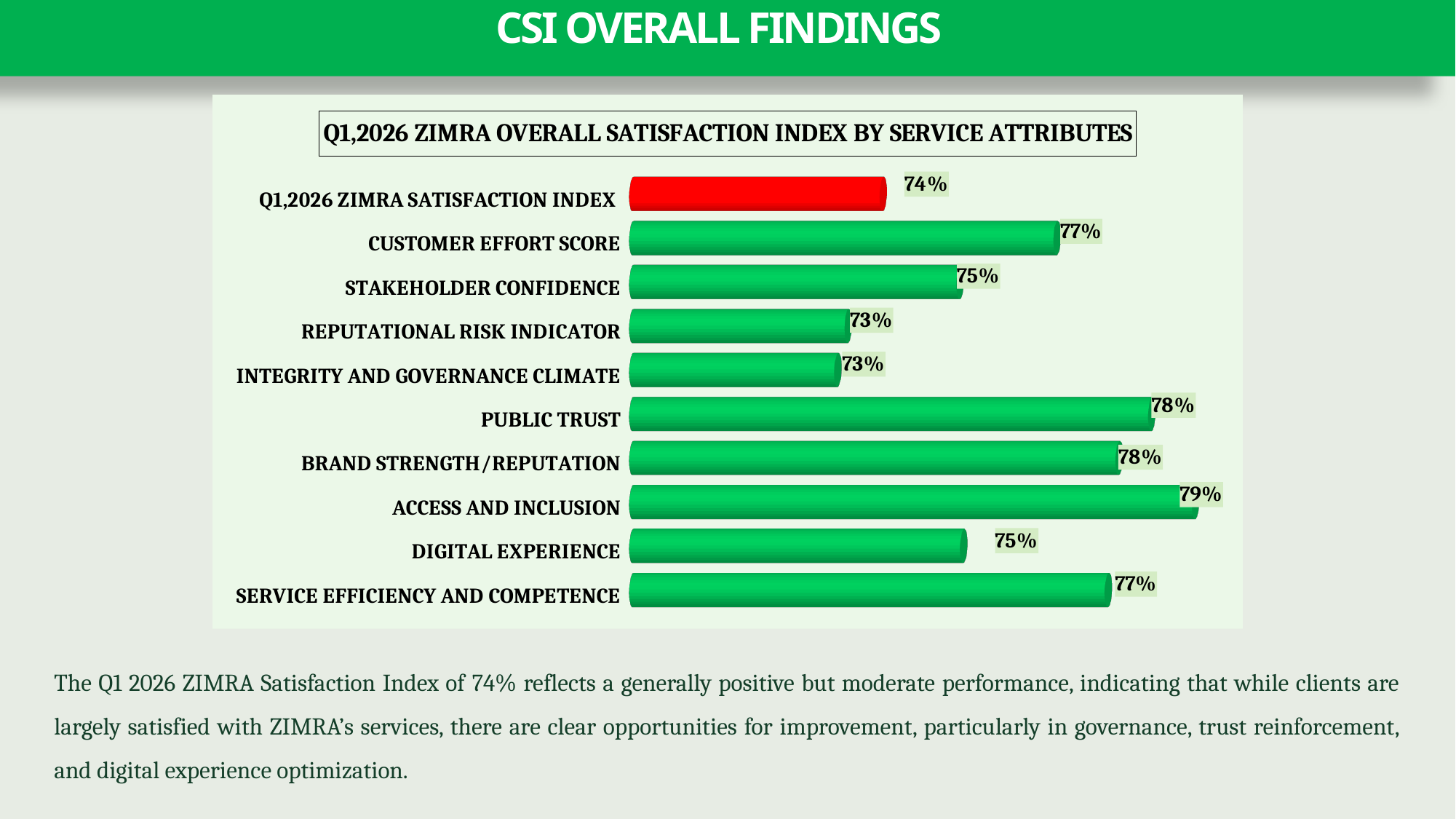
What is the value for ACCESS AND INCLUSION? 79% What is the difference between ACCESS AND INCLUSION and INTEGRITY AND GOVERNANCE CLIMATE? 6% How many bars are shown in the chart? 10 Which is larger, DIGITAL EXPERIENCE or BRAND STRENGTH/REPUTATION? BRAND STRENGTH/REPUTATION What is the difference between PUBLIC TRUST and STAKEHOLDER CONFIDENCE? 3% What is the value for the Q1,2026 ZIMRA SATISFACTION INDEX bar? 74% What is the value for CUSTOMER EFFORT SCORE? 77% What is the value for DIGITAL EXPERIENCE? 75% What kind of chart is shown on the slide? Bar chart What is the title of the chart? Q1,2026 ZIMRA OVERALL SATISFACTION INDEX BY SERVICE ATTRIBUTES Which is larger, CUSTOMER EFFORT SCORE or REPUTATIONAL RISK INDICATOR? CUSTOMER EFFORT SCORE Which category has the highest value? ACCESS AND INCLUSION